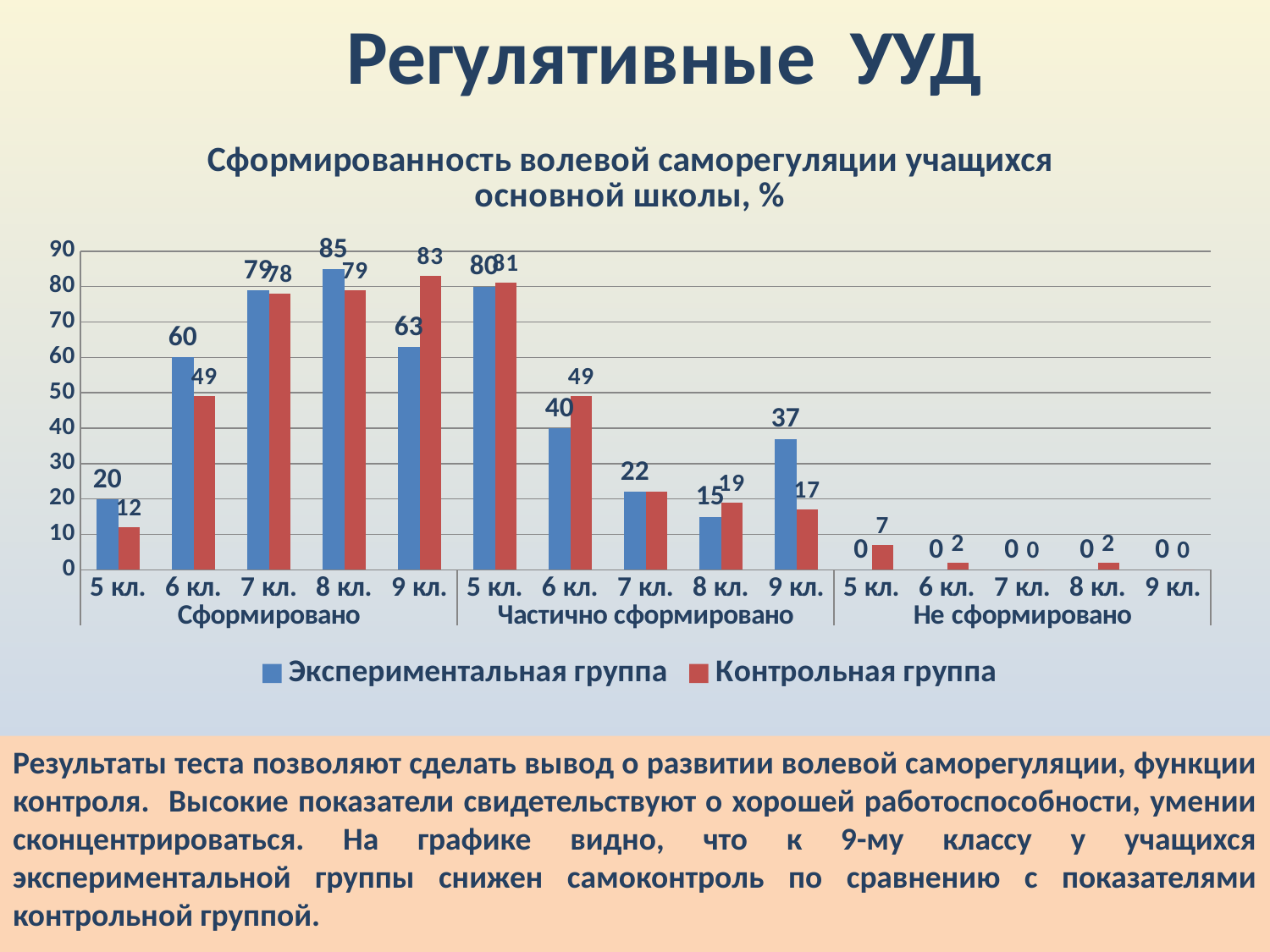
Under Частично сформировано in 6 кл., which group has the larger value? Контрольная группа Which class has the lowest value for the Контрольная группа under Сформировано? 5 кл. How many class categories are shown under Не сформировано? 5 What is the value for the Контрольная группа in 9 кл. under Сформировано? 83 Which class has the highest value for the Экспериментальная группа under Сформировано? 8 кл. What is the value for the Контрольная группа in 5 кл. under Не сформировано? 7 What kind of chart is shown on the slide? Bar chart What is the value for the Экспериментальная группа in 9 кл. under Частично сформировано? 37 What is the value for the Экспериментальная группа in 8 кл. under Сформировано? 85 How many series does the legend list? 2 What is the difference between the Контрольная группа and the Экспериментальная группа in 9 кл. under Сформировано? 20 What colour represents the Контрольная группа in the chart? Red